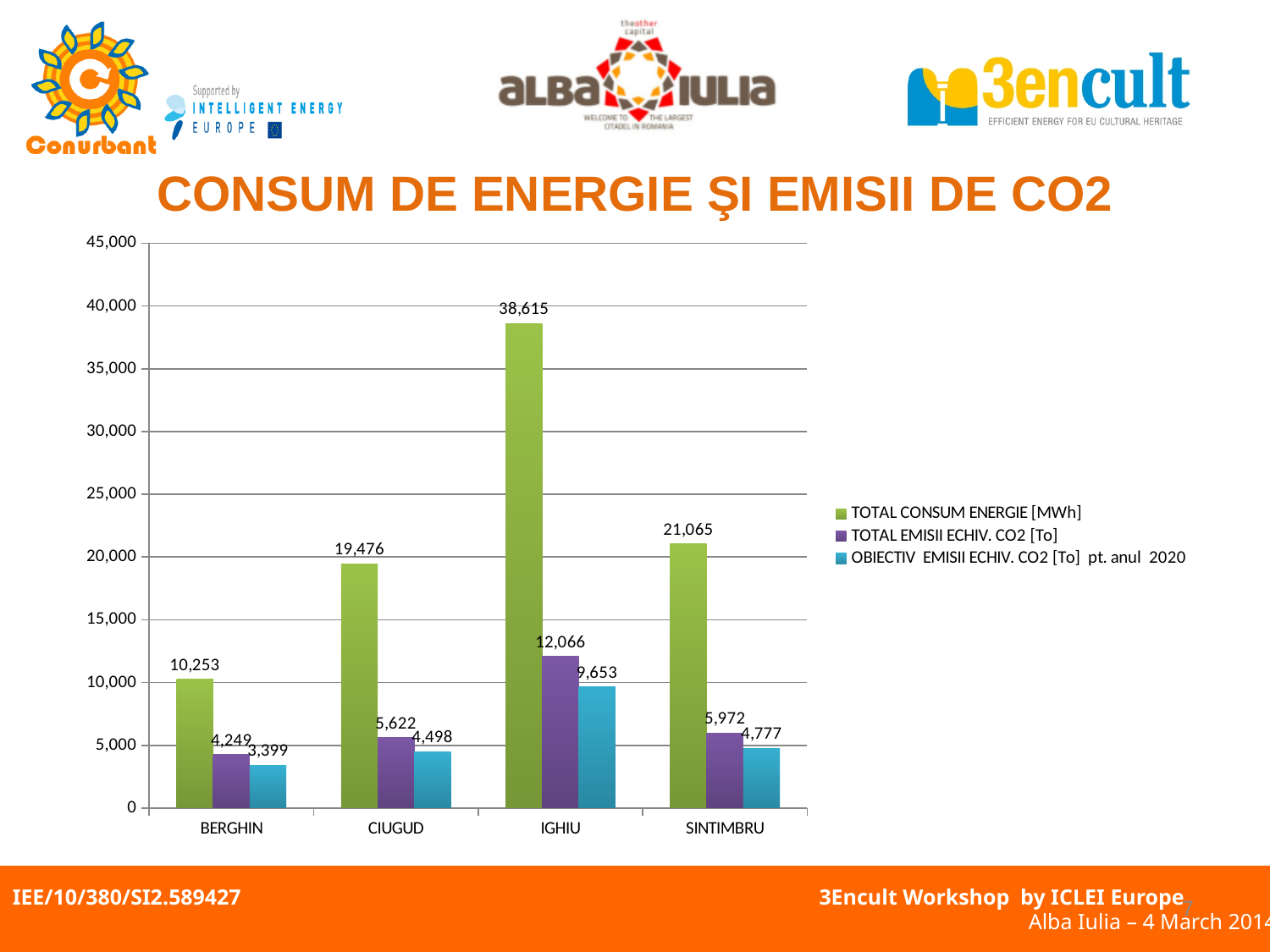
How many categories are shown on the x axis? 4 Is the TOTAL CONSUM ENERGIE [MWh] value for BERGHIN greater or less than 15,000? less What is the title of the chart? CONSUM DE ENERGIE ŞI EMISII DE CO2 What is the OBIECTIV EMISII ECHIV. CO2 [To] pt. anul 2020 value for SINTIMBRU? 4,777 What is the difference between the TOTAL CONSUM ENERGIE [MWh] values for SINTIMBRU and CIUGUD? 1,589 What is the TOTAL CONSUM ENERGIE [MWh] value for IGHIU? 38,615 What kind of chart is shown on the slide? bar chart Which is larger: the TOTAL EMISII ECHIV. CO2 [To] for SINTIMBRU or for CIUGUD? SINTIMBRU Which category has the lowest TOTAL EMISII ECHIV. CO2 [To]? BERGHIN How many series does the legend list? 3 Which category has the highest TOTAL CONSUM ENERGIE [MWh]? IGHIU What is the TOTAL EMISII ECHIV. CO2 [To] value for CIUGUD? 5,622